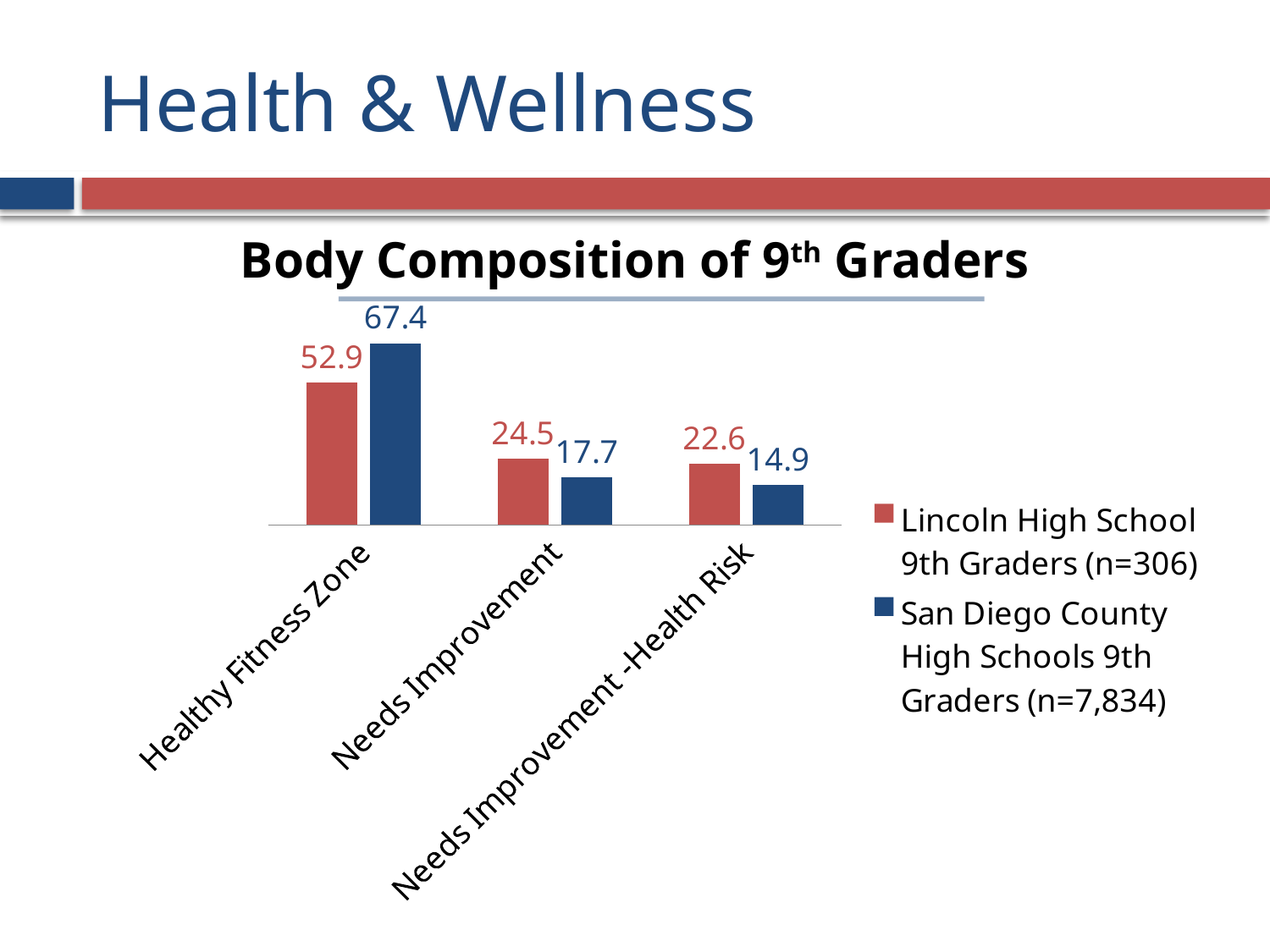
Which category has the lowest value for Lincoln High School 9th Graders? Needs Improvement - Health Risk What kind of chart is shown on the slide? Bar chart What is the difference between the Lincoln High School and San Diego County values in the Needs Improvement category? 6.8 What is the value for San Diego County High Schools 9th Graders in the Healthy Fitness Zone category? 67.4 Which category has the highest value for San Diego County High Schools 9th Graders? Healthy Fitness Zone How many series does the legend list? 2 What is the difference between the San Diego County and Lincoln High School values in the Healthy Fitness Zone category? 14.5 How many categories are shown on the x axis? 3 In the Needs Improvement - Health Risk category, which series has the larger value, Lincoln High School or San Diego County High Schools? Lincoln High School 9th Graders What is the value for Lincoln High School 9th Graders in the Healthy Fitness Zone category? 52.9 What is the value for Lincoln High School 9th Graders in the Needs Improvement category? 24.5 What is the value for San Diego County High Schools 9th Graders in the Needs Improvement - Health Risk category? 14.9